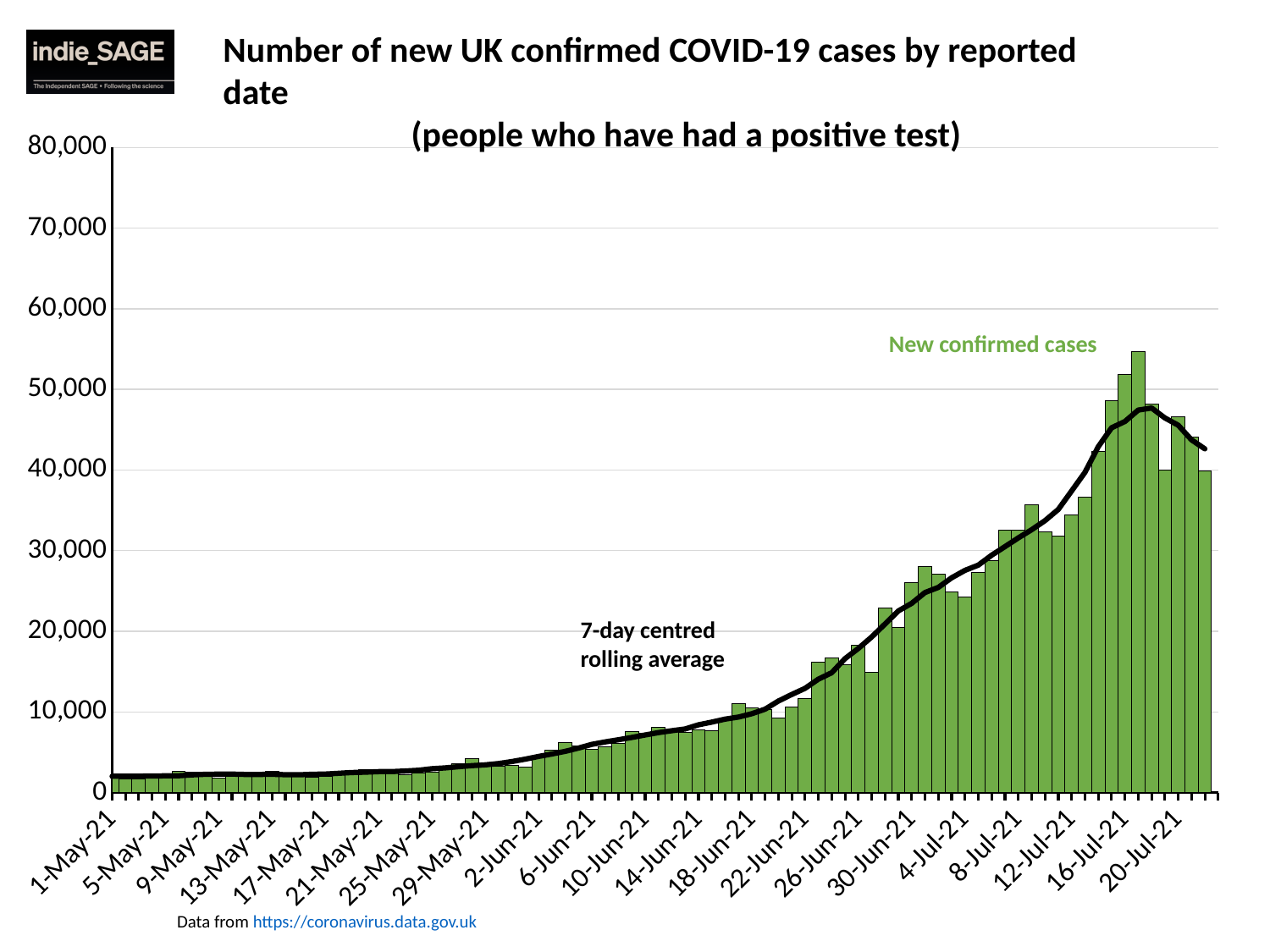
Is the highest bar on the chart greater or less than 50,000? greater Is the value for 2-Jun-21 greater or less than 10,000? less What colour are the bars for new confirmed cases? green Do new confirmed cases generally rise or fall from 1-May-21 to 16-Jul-21? rise What kind of chart is shown on the slide? combination bar and line chart What does the black line on the chart represent? 7-day centred rolling average Is the value for 8-Jul-21 greater or less than 20,000? greater Which is larger, the value for 1-May-21 or the value for 16-Jul-21? 16-Jul-21 How many data series are plotted on the chart? 2